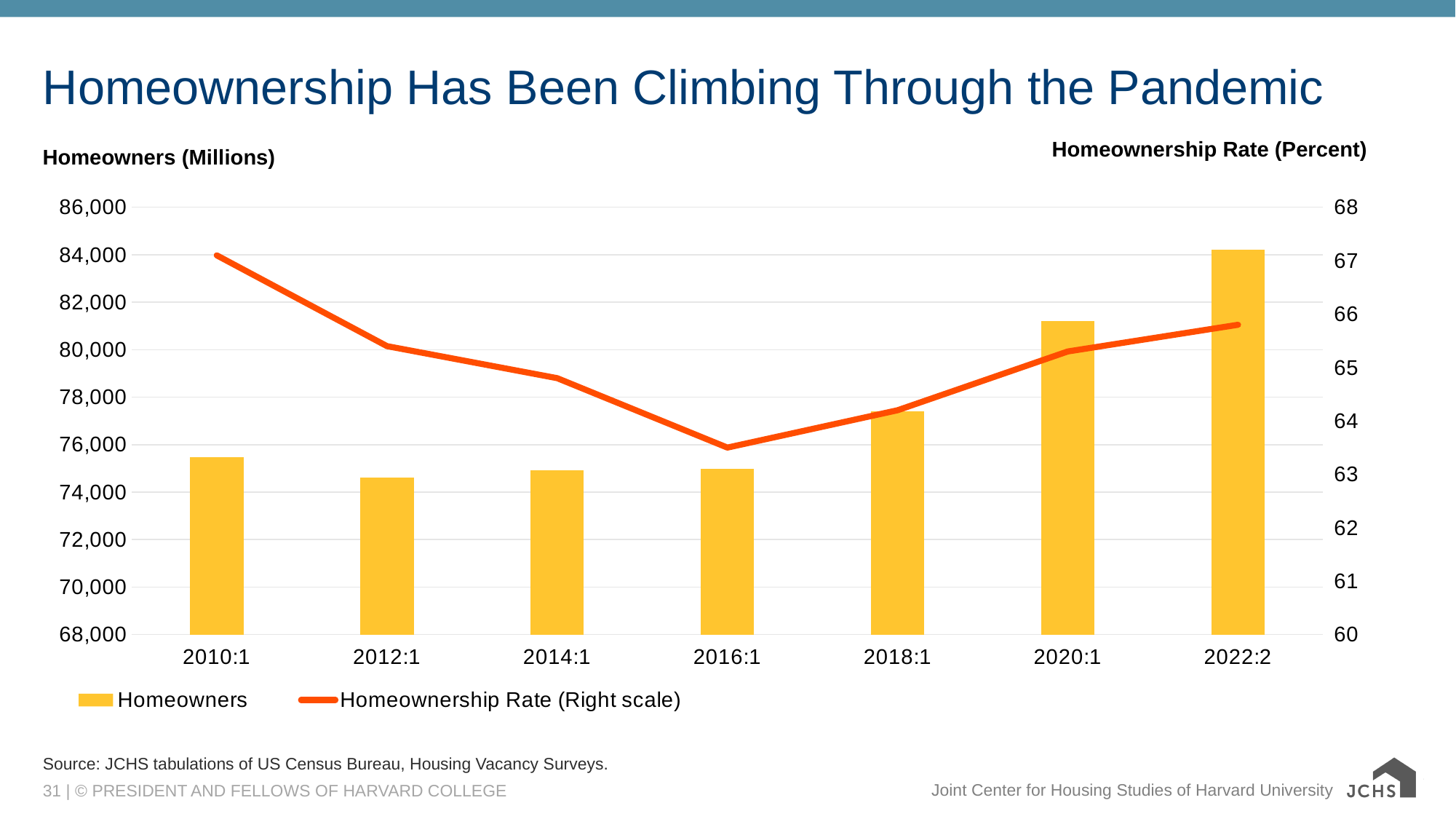
Is the number of homeowners in 2020:1 greater or less than 80,000? greater Is the number of homeowners in 2018:1 greater or less than 78,000? less How many time periods are shown on the x axis? 7 In which period is the homeownership rate highest? 2010:1 Which period has the highest number of homeowners? 2022:2 Is the homeownership rate in 2016:1 greater or less than 64? less Which period has more homeowners, 2018:1 or 2020:1? 2020:1 What kind of chart is shown on the slide? A combination bar and line chart What is the label of the right-hand axis? Homeownership Rate (Percent) In which period is the homeownership rate lowest? 2016:1 How many series does the legend list? 2 How does the homeownership rate change from 2010:1 to 2016:1? It falls